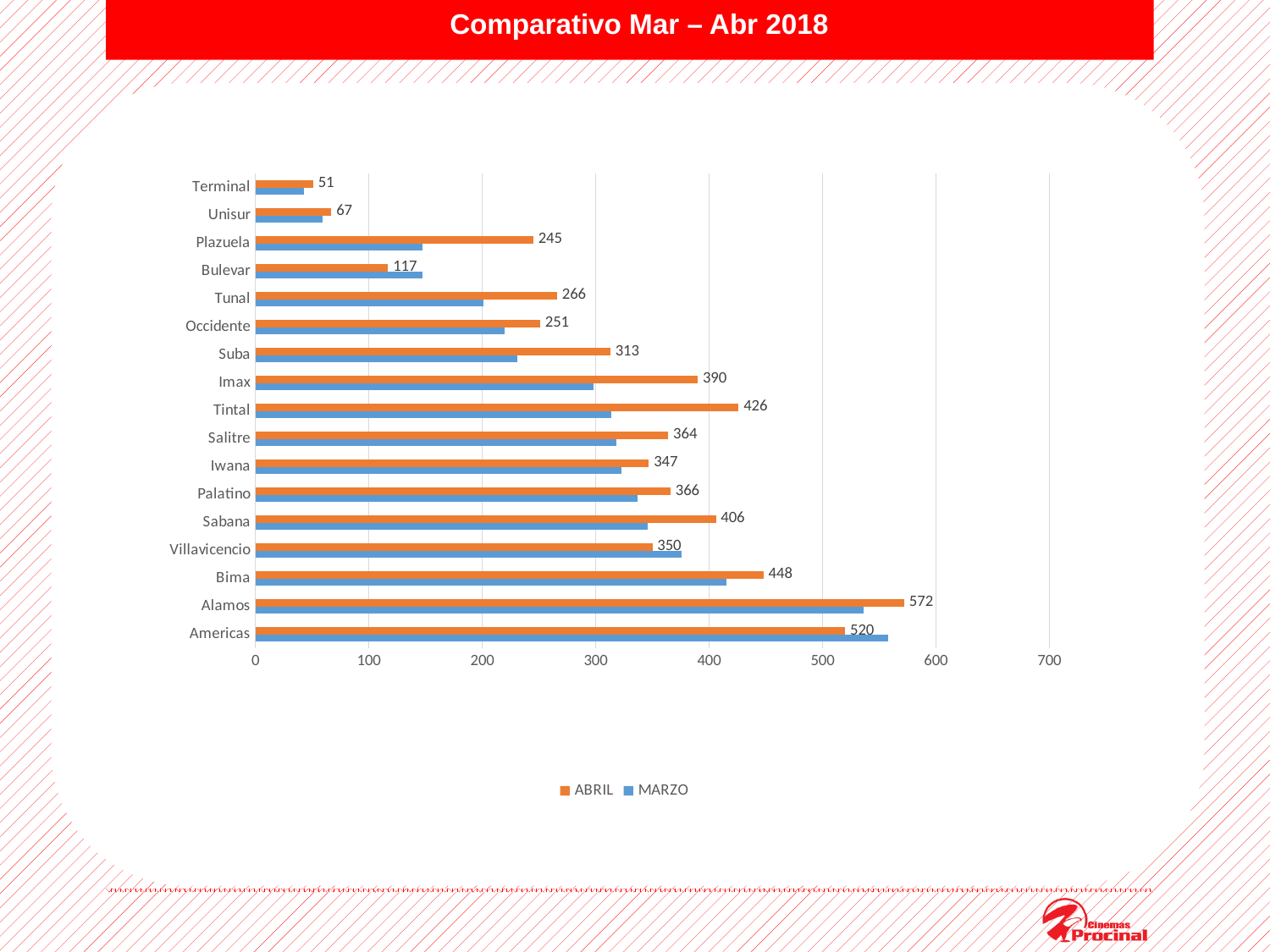
How many series does the legend list? 2 Which category has the lowest ABRIL value? Terminal What is the difference between the ABRIL values for Alamos and Americas? 52 Is the MARZO value for Terminal greater or less than 100? less What is the ABRIL value for Bulevar? 117 Is the MARZO value for Americas greater or less than 500? greater What kind of chart is shown on the slide? Bar chart Which has the larger ABRIL value, Sabana or Palatino? Sabana What is the title of the slide? Comparativo Mar – Abr 2018 Which category has the highest ABRIL value? Alamos How many categories are shown on the chart? 17 What is the ABRIL value for Tintal? 426